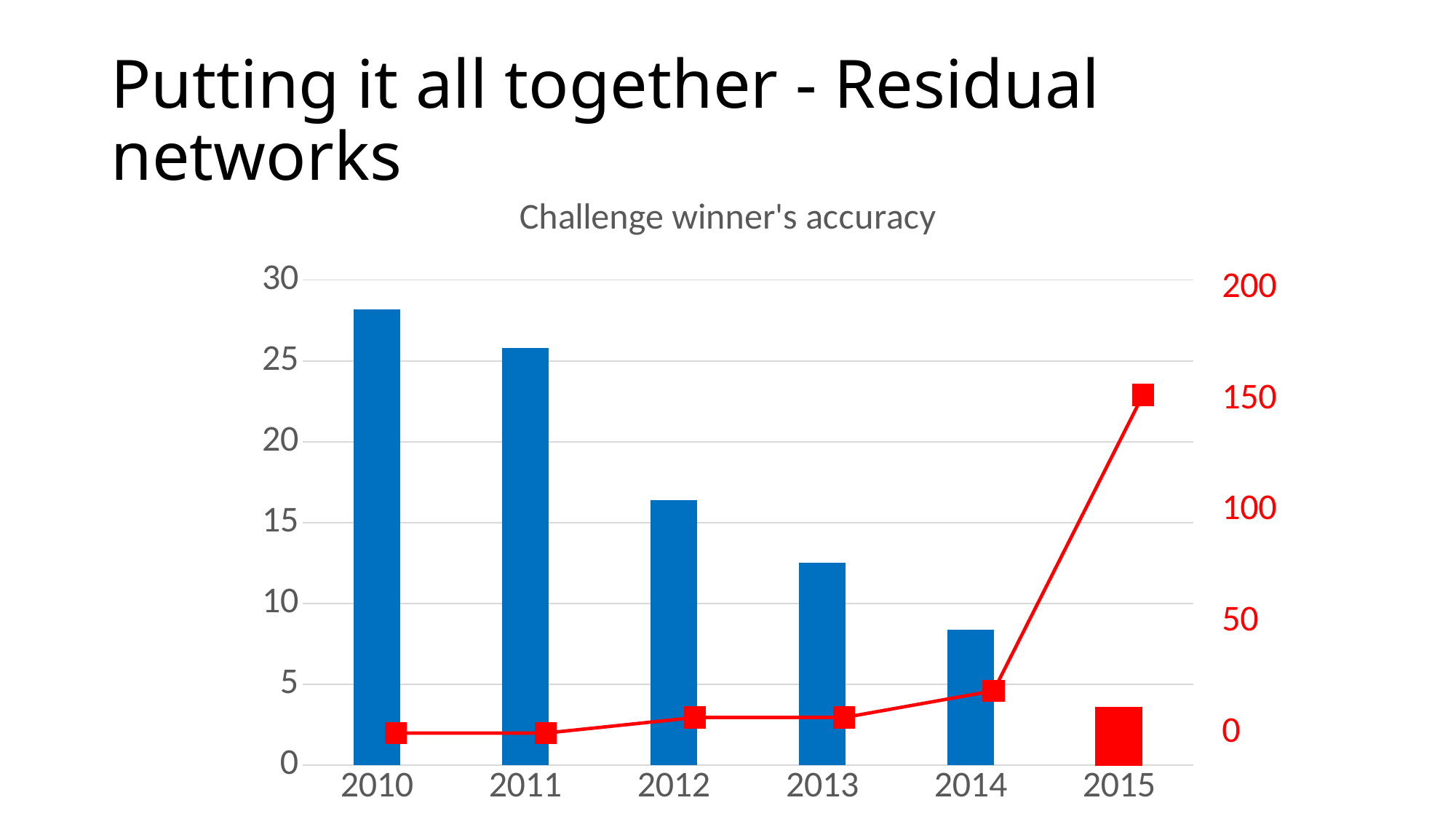
Is the bar value for 2014 greater or less than 10 on the left axis? less Is the bar value for 2015 greater or less than 5 on the left axis? less Which year has the tallest bar in the chart? 2010 How many years are shown on the x axis of the chart? 6 Is the bar value for 2010 greater or less than 25 on the left axis? greater Do the bar values rise or fall from 2010 to 2015? fall Which year has the shortest bar in the chart? 2015 What is the title of the chart? Challenge winner's accuracy Which year has the taller bar, 2011 or 2012? 2011 What kind of chart is shown on the slide? A combined bar and line chart